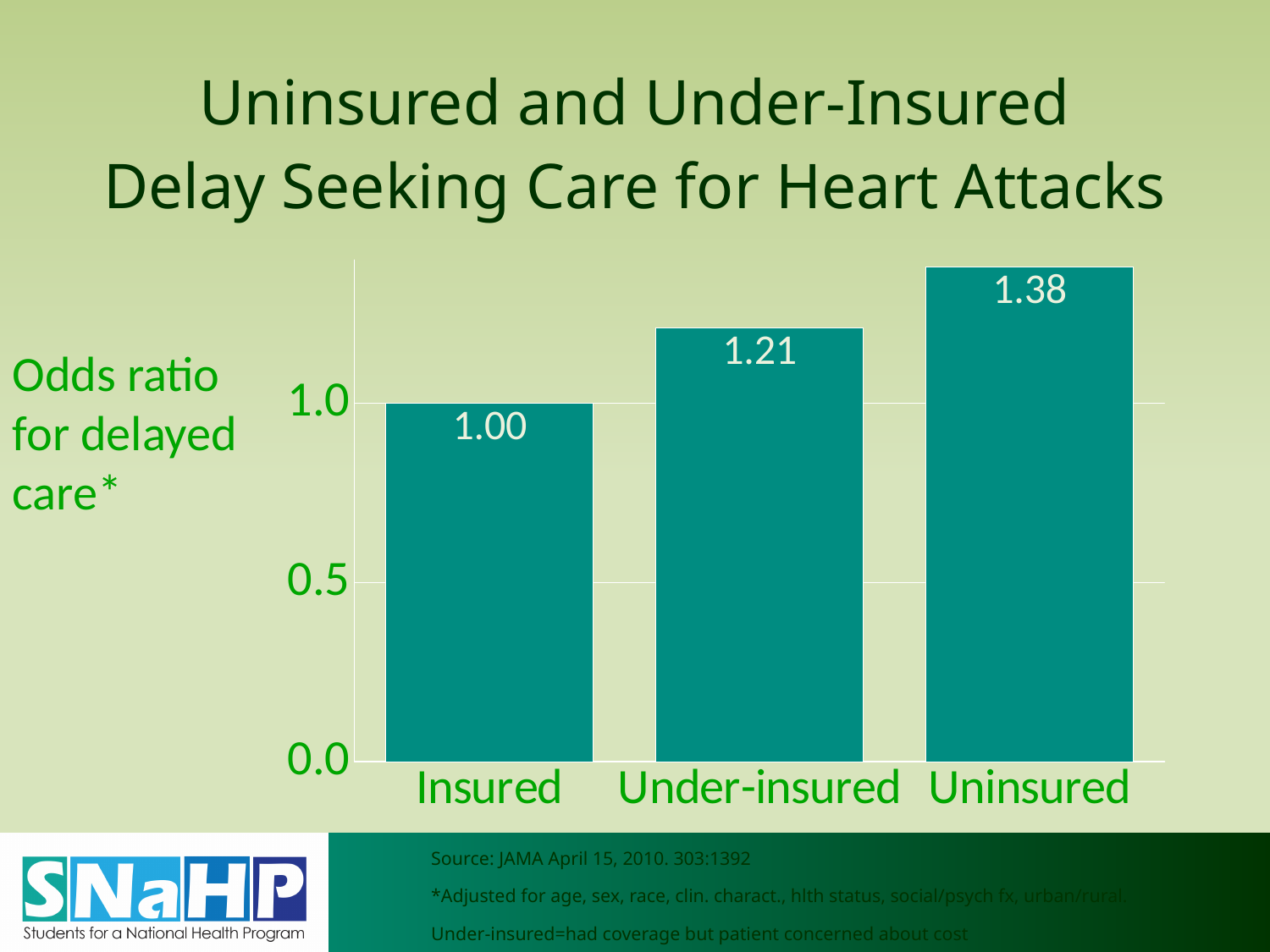
Is the odds ratio for the Under-insured group greater or less than 1.0? greater What kind of chart is shown on the slide? Bar chart What is the difference between the odds ratios for the Uninsured and Insured groups? 0.38 How many groups are shown in the chart? 3 Which group has a larger odds ratio for delayed care, Under-insured or Uninsured? Uninsured Which group has the lowest odds ratio for delayed care? Insured What is the odds ratio for delayed care for the Uninsured group? 1.38 Do the odds ratios rise or fall from Insured to Uninsured along the x axis? Rise What is the odds ratio for delayed care for the Under-insured group? 1.21 Which group has the highest odds ratio for delayed care? Uninsured What is the odds ratio for delayed care for the Insured group? 1.00 What is the difference between the odds ratios for the Uninsured and Under-insured groups? 0.17